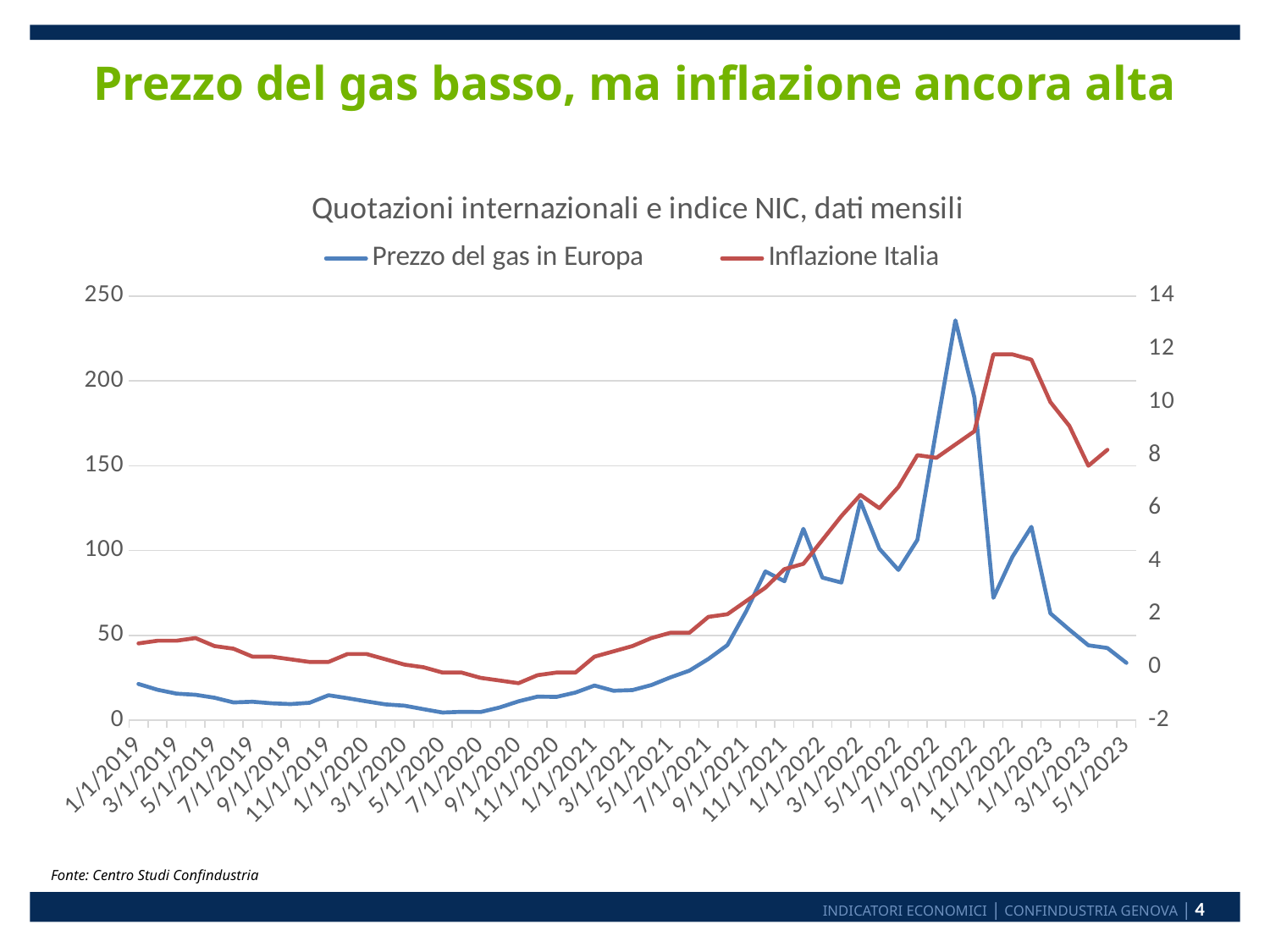
Which series is drawn in blue? Prezzo del gas in Europa How many series does the chart legend list? 2 Does Inflazione Italia rise or fall between 1/1/2021 and 11/1/2022? rise What kind of chart is shown on the slide? line chart Is the peak value of Inflazione Italia greater or less than 10? greater Does Prezzo del gas in Europa rise or fall between 9/1/2022 and 5/1/2023? fall In which year does Prezzo del gas in Europa reach its highest value? 2022 Is the value of Prezzo del gas in Europa at 5/1/2023 greater or less than 50? less Is the value of Inflazione Italia at 1/1/2019 greater or less than 2? less What is the title of the chart? Quotazioni internazionali e indice NIC, dati mensili